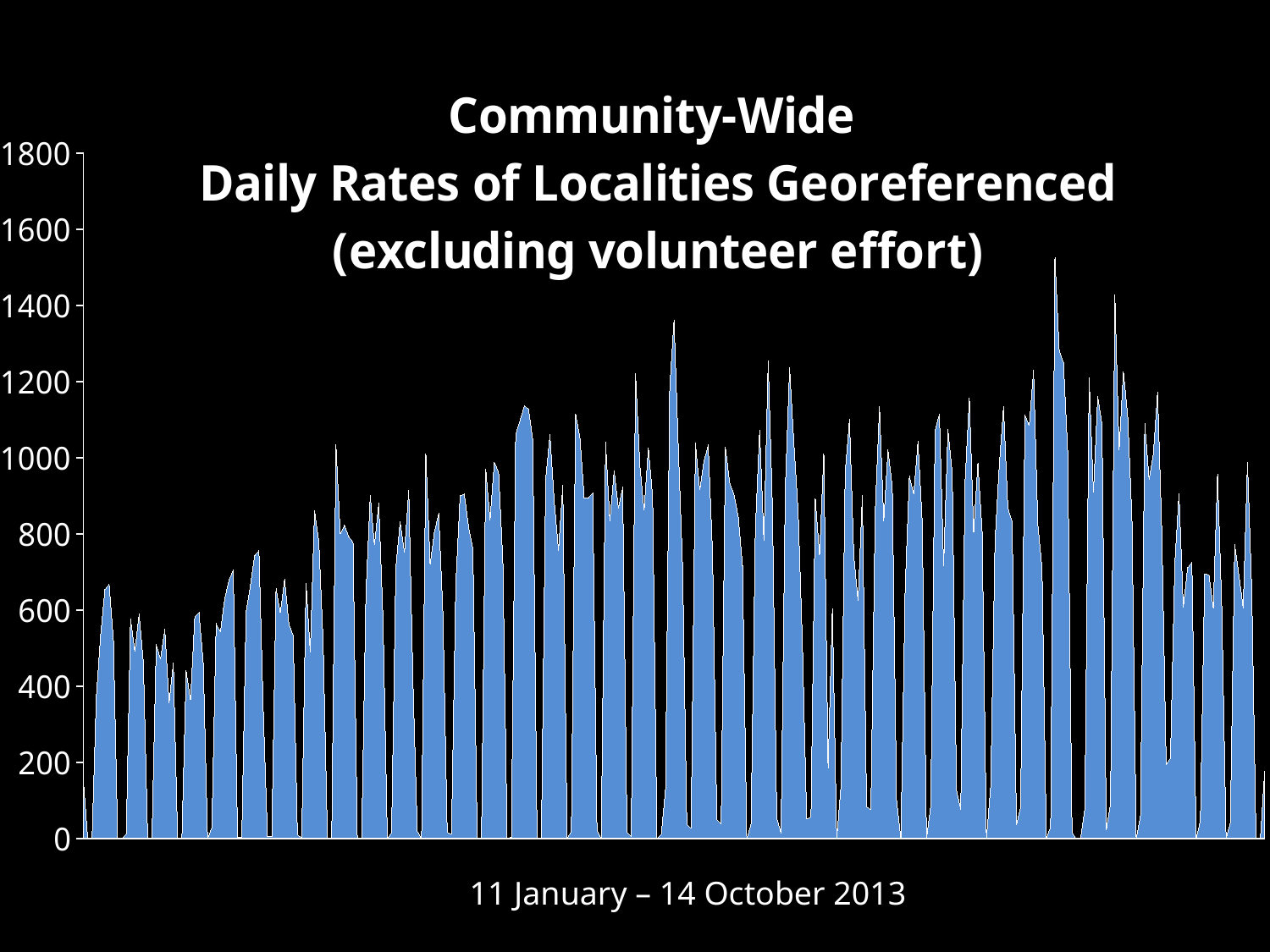
Do the daily peaks generally rise or fall from January toward October along the x-axis? rise Is the first peak at the left of the chart (in January) greater or less than 800? less Is the lowest value reached between the weekly peaks greater or less than 200? less Is the highest daily peak in the chart greater or less than 1600? less What is the interval between consecutive tick marks on the y-axis? 200 What is the title of the chart? Community-Wide Daily Rates of Localities Georeferenced (excluding volunteer effort) What is the highest value shown on the y-axis of the chart? 1800 How many data series are plotted in the chart? 1 What date range does the x-axis label give for the chart? 11 January – 14 October 2013 What kind of chart is shown on the slide? Area chart